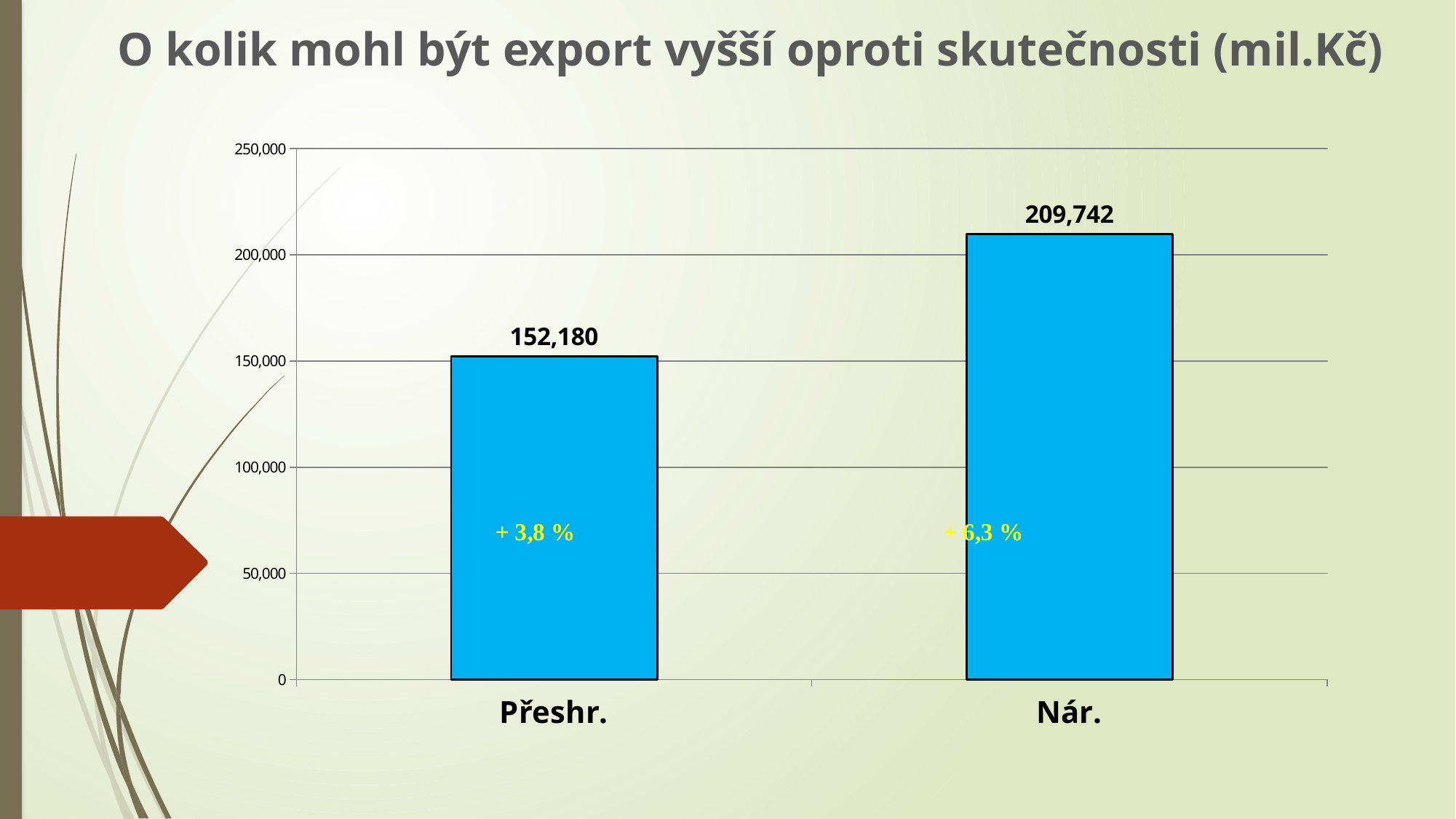
What is the difference between the values for Nár. and Přeshr.? 57,562 What is the value for Přeshr.? 152,180 Which category has the highest value? Nár. Which category has the lowest value? Přeshr. What kind of chart is shown on the slide? bar chart Which is larger, the value for Přeshr. or the value for Nár.? Nár. How many categories are shown on the x axis? 2 What percentage label is printed inside the Přeshr. bar? + 3,8 % What percentage label is printed inside the Nár. bar? + 6,3 % Is the value for Nár. greater or less than 200,000? greater Is the value for Přeshr. greater or less than 200,000? less What is the value for Nár.? 209,742